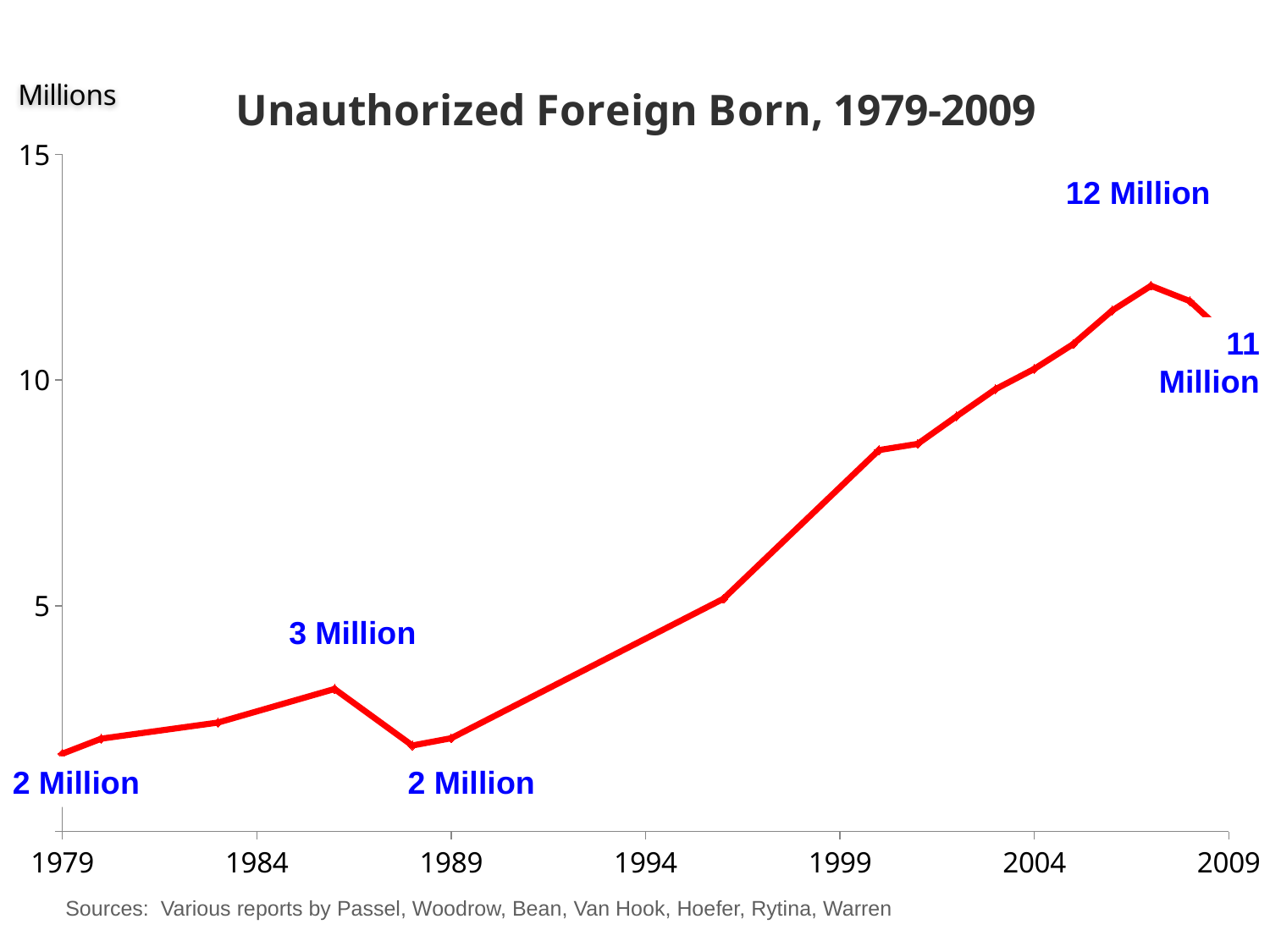
What unit is the vertical axis labelled in? Millions What kind of chart is shown on the slide? line chart Overall, do the values rise or fall from 1979 to 2009? rise What is the title of the chart? Unauthorized Foreign Born, 1979-2009 What value is annotated at the end of the line in 2009? 11 Million What value is annotated at the start of the line in 1979? 2 Million What value is annotated at the small peak in the mid-1980s? 3 Million What value is annotated at the peak of the line around 2007? 12 Million Is the value for 1999 greater or less than 10? less Is the value for 1999 greater or less than 5? greater Is the value for 1994 greater or less than 5? less